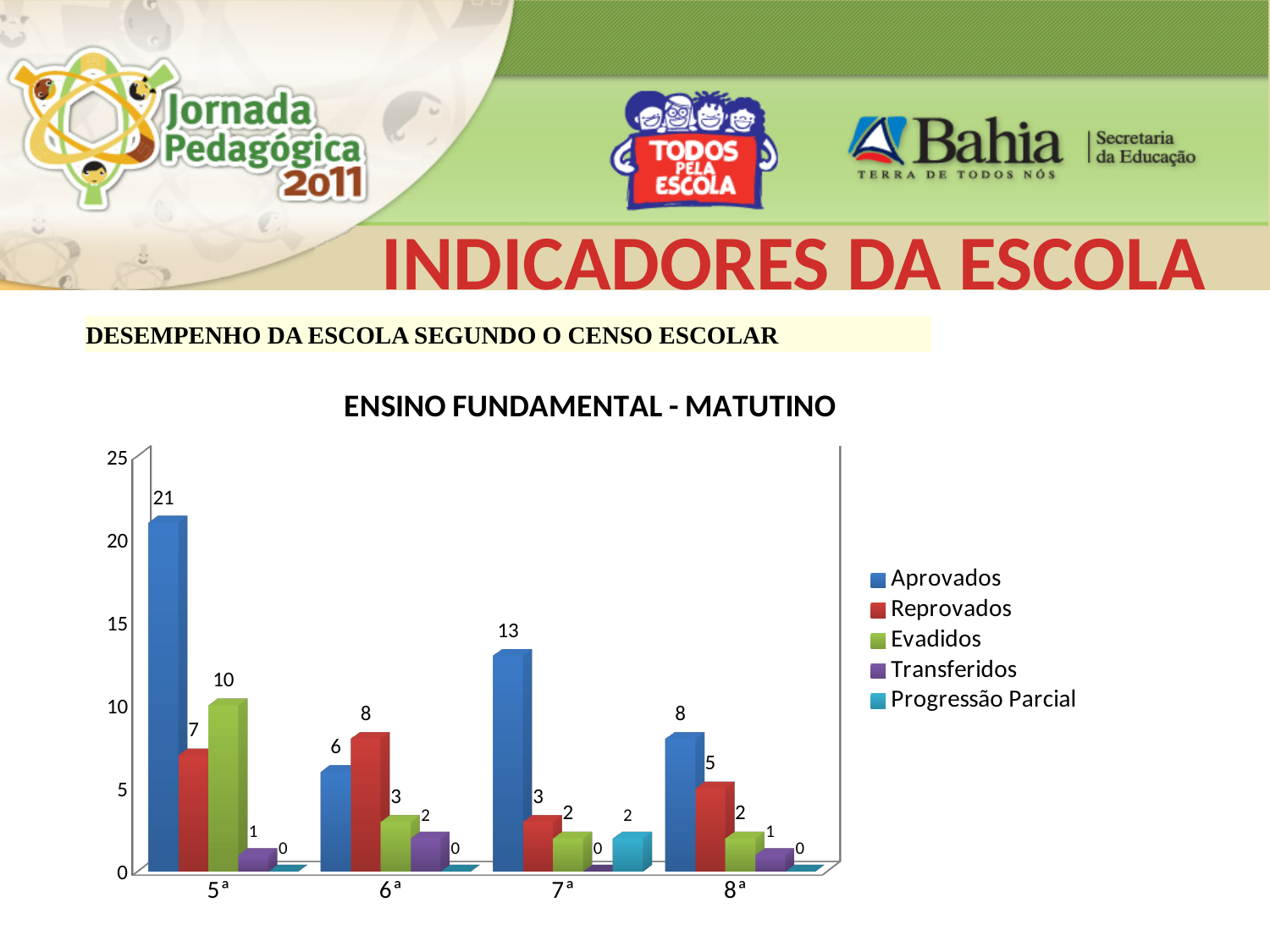
Which grade has the highest value for Aprovados? 5ª What is the value for Evadidos in 5ª? 10 In 6ª, which is larger, Aprovados or Reprovados? Reprovados How many grade categories are shown on the x axis? 4 How many series does the legend list? 5 What is the value for Reprovados in 6ª? 8 What is the value for Aprovados in 5ª? 21 What is the value for Progressão Parcial in 7ª? 2 What is the title of the chart? ENSINO FUNDAMENTAL - MATUTINO What is the difference between Aprovados in 5ª and Aprovados in 7ª? 8 Which grade has the lowest value for Aprovados? 6ª What kind of chart is shown on the slide? Bar chart